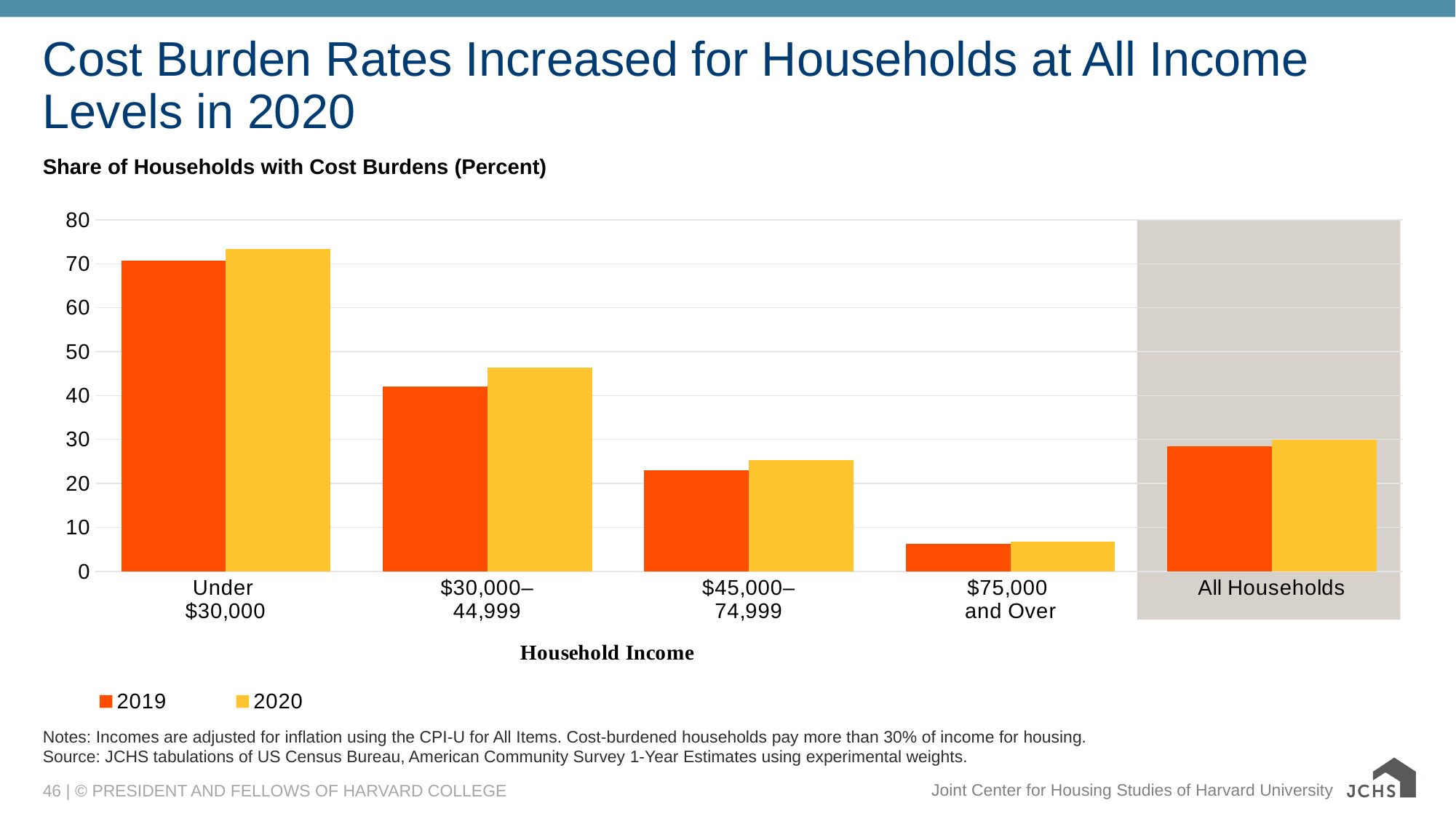
For the $30,000–44,999 category, which year has the larger share of cost-burdened households, 2019 or 2020? 2020 How many series does the legend list? 2 Which series is shown in orange in the legend? 2019 How many income categories are shown on the x axis? 5 Is the 2020 value for $75,000 and Over greater or less than 10? less Is the 2019 value for $45,000–74,999 greater or less than 20? greater Is the 2020 value for $30,000–44,999 greater or less than 50? less Which income category has the lowest share of households with cost burdens in 2019? $75,000 and Over Which income category has the highest share of households with cost burdens in 2020? Under $30,000 What kind of chart is shown on the slide? bar chart Moving from Under $30,000 to $75,000 and Over, do the 2019 values rise or fall? fall